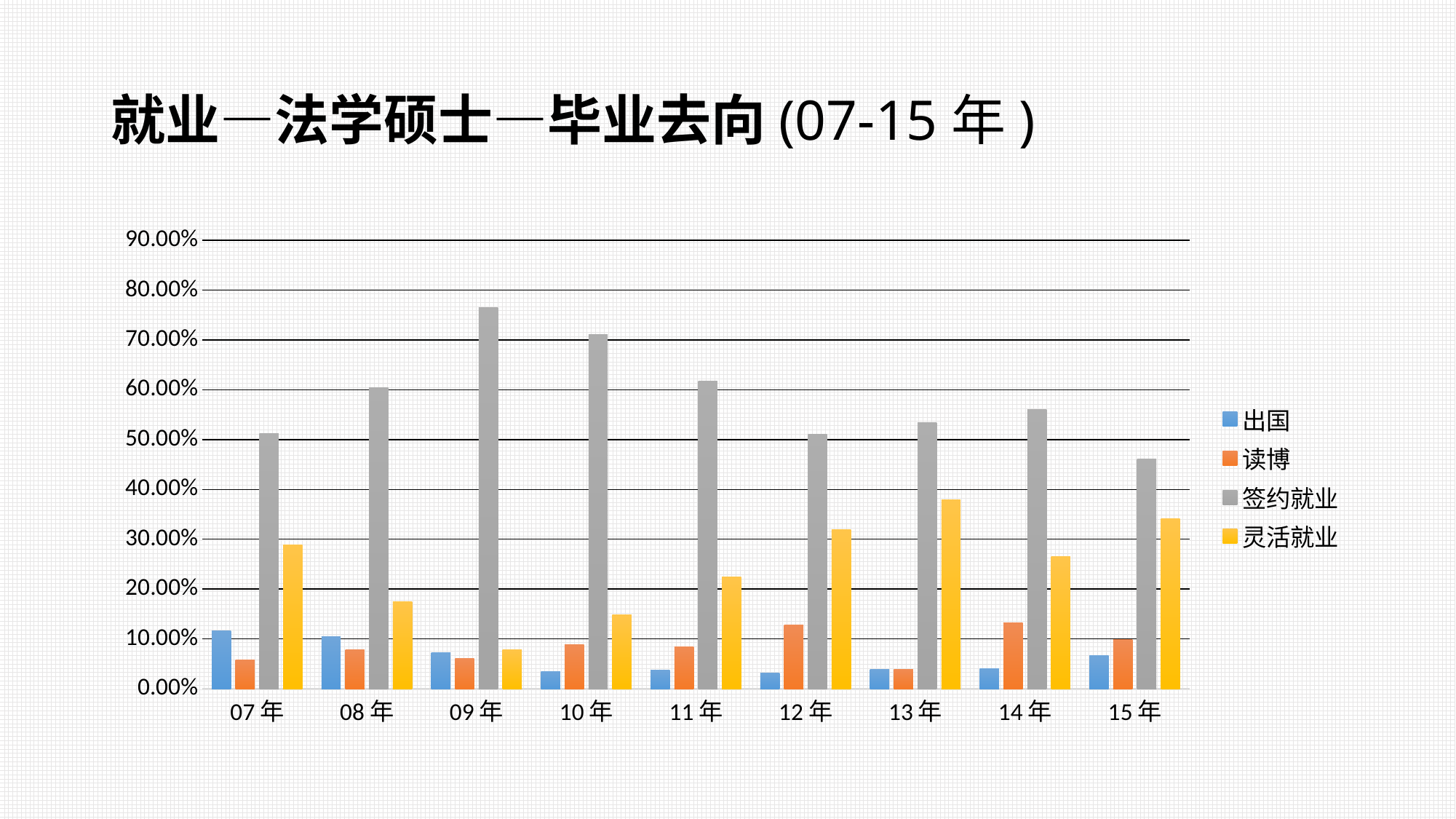
In which year is the 签约就业 bar the highest? 09 年 What are the four entries listed in the legend? 出国, 读博, 签约就业, 灵活就业 How many year categories are shown on the x axis? 9 Is the value for 签约就业 in 09 年 greater or less than 70.00%? greater In which year is the 灵活就业 bar the highest? 13 年 In which year is the 灵活就业 bar the lowest? 09 年 Is the value for 签约就业 in 15 年 greater or less than 50.00%? less In which year is the 签约就业 bar the lowest? 15 年 What kind of chart is shown on the slide? bar chart How many series does the legend list? 4 Is the value for 灵活就业 in 07 年 greater or less than 20.00%? greater In 12 年, which is larger: 读博 or 出国? 读博